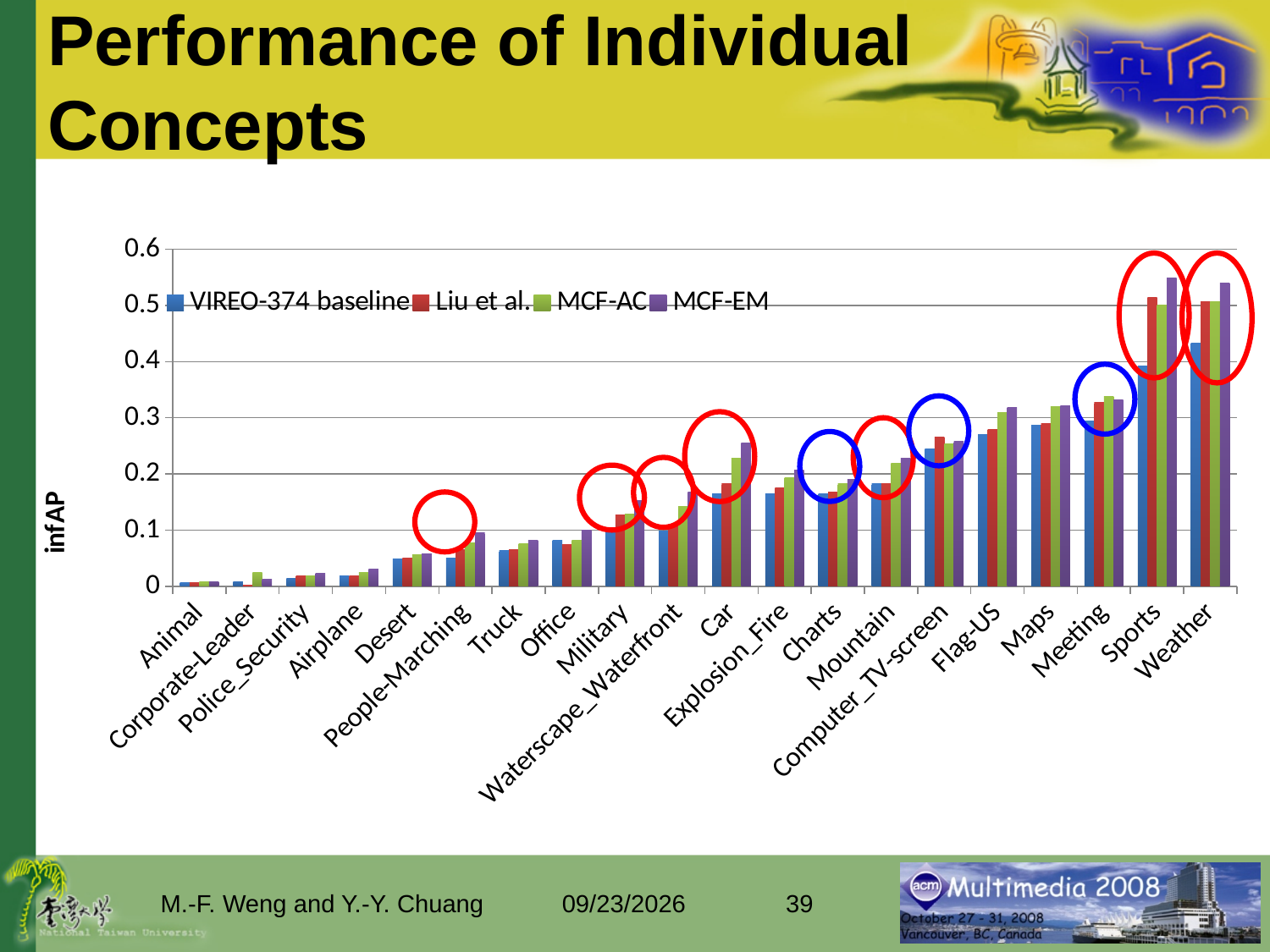
Is the VIREO-374 baseline value for Weather greater or less than 0.4? greater How many series does the legend list? 4 What kind of chart is shown on the slide? bar chart Which concept has the lowest values across all series? Animal Which series is listed first in the legend? VIREO-374 baseline What is the label of the y axis? infAP Which series has the highest value for Sports? MCF-EM Do the values generally rise or fall moving from left to right along the x axis? rise How many concept categories are shown along the x axis? 20 Is the MCF-EM value for Car greater or less than 0.2? greater For Weather, which series has the larger value: MCF-EM or VIREO-374 baseline? MCF-EM